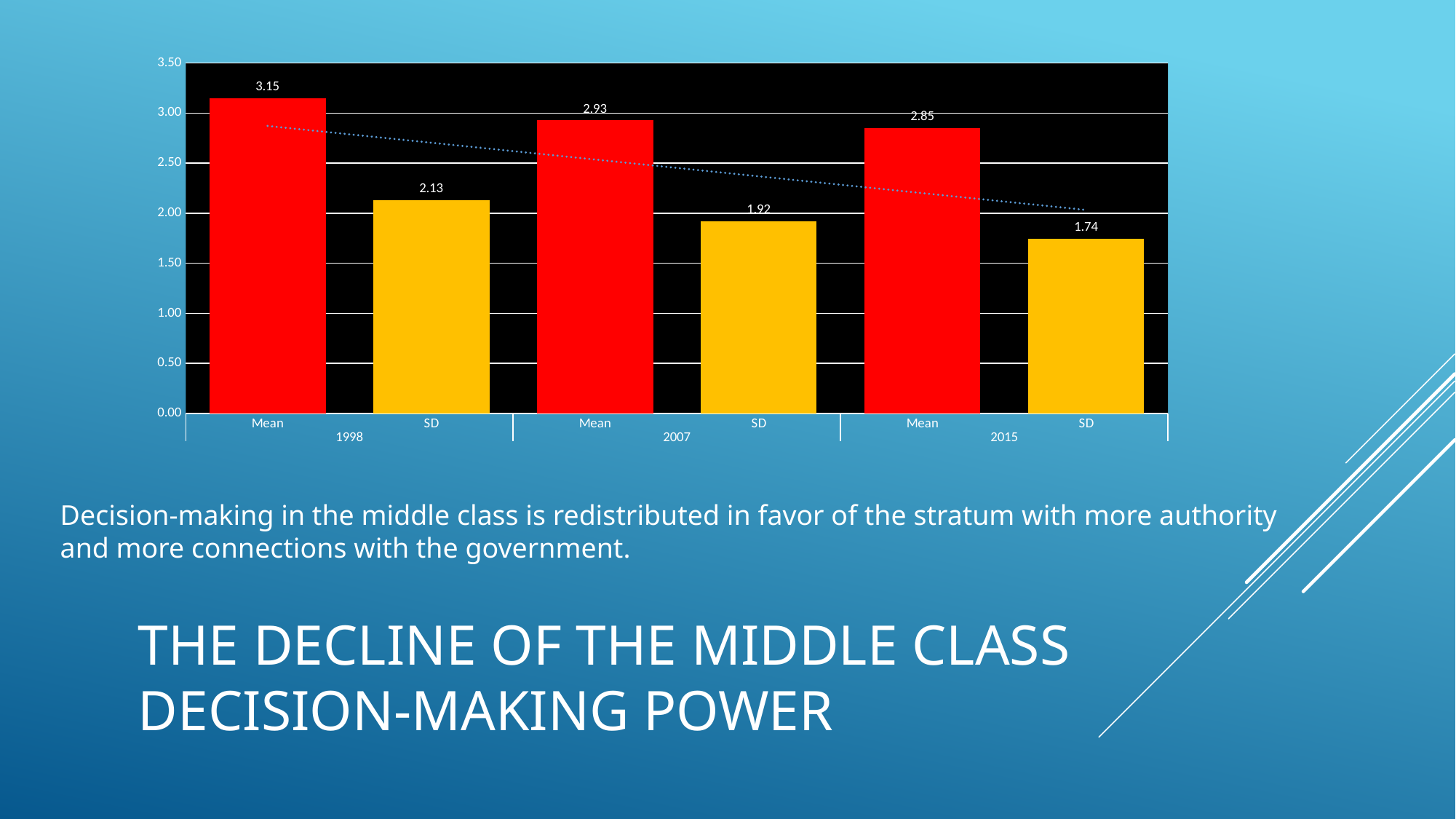
What is the difference between the SD value for 1998 and the SD value for 2007? 0.21 What is the SD value for 2015? 1.74 Which is larger, the Mean value for 2007 or the Mean value for 2015? Mean value for 2007 What kind of chart is shown on the slide? Bar chart How many bars are plotted in the chart? 6 What is the Mean value for 2015? 2.85 What is the SD value for 2007? 1.92 Do the Mean values rise or fall from 1998 to 2015? Fall Which year has the highest Mean value? 1998 What is the difference between the Mean value for 1998 and the Mean value for 2015? 0.30 What is the Mean value for 1998? 3.15 Which year has the lowest SD value? 2015